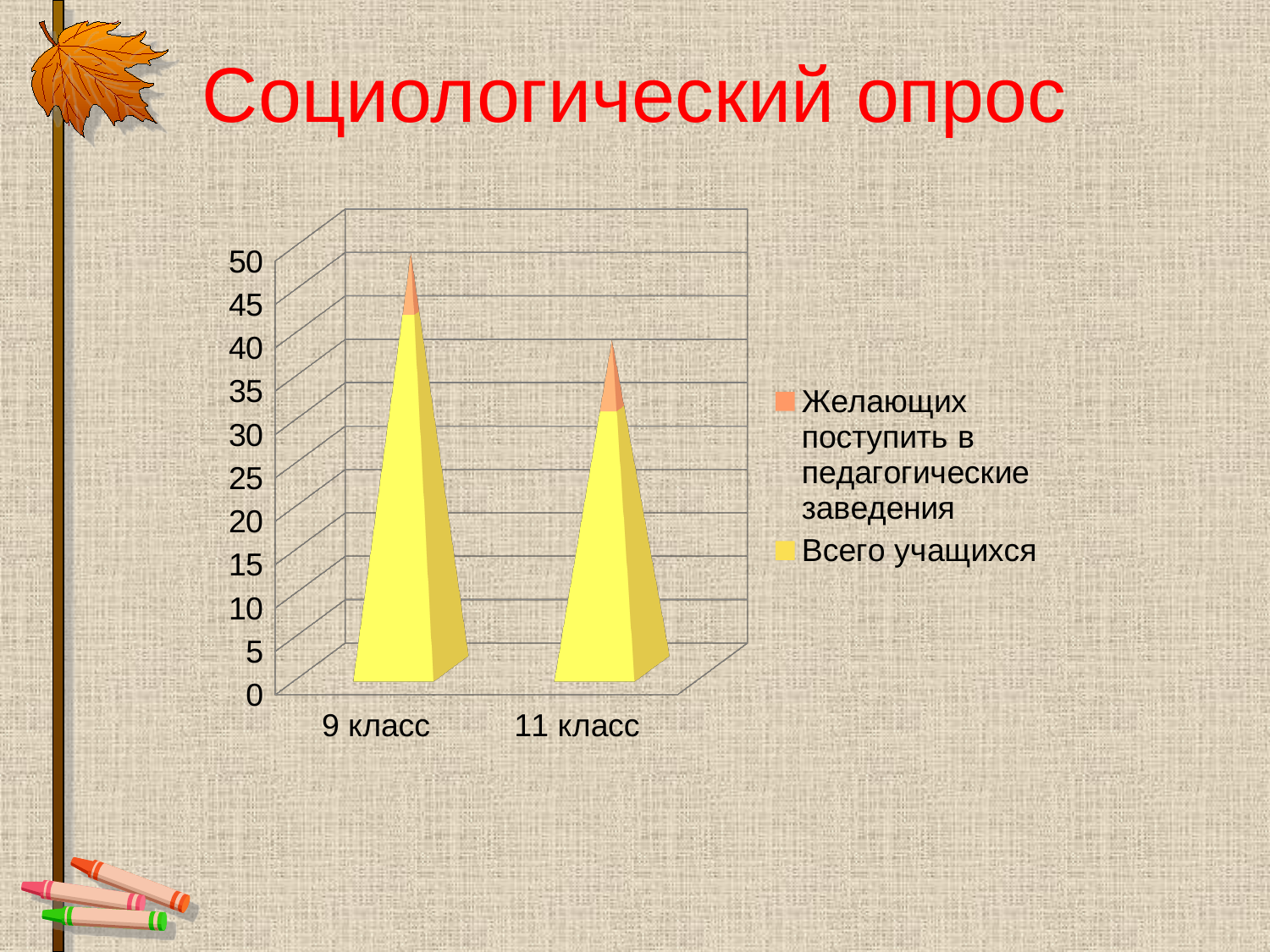
Do the stacked bar heights rise or fall from 9 класс to 11 класс? fall Is the stacked bar for 9 класс taller or shorter than the bar for 11 класс? taller How many categories are shown on the x axis of the chart? 2 Which category has the shorter stacked bar? 11 класс What is the title of the slide containing the chart? Социологический опрос How many series does the chart legend list? 2 Which series is shown in yellow in the chart legend? Всего учащихся Is the total stacked value for 11 класс greater or less than 45? less Is the total stacked value for 9 класс greater or less than 40? greater Is the total stacked value for 11 класс greater or less than 30? greater What kind of chart is shown on the slide? Stacked bar chart Which category has the taller stacked bar, 9 класс or 11 класс? 9 класс